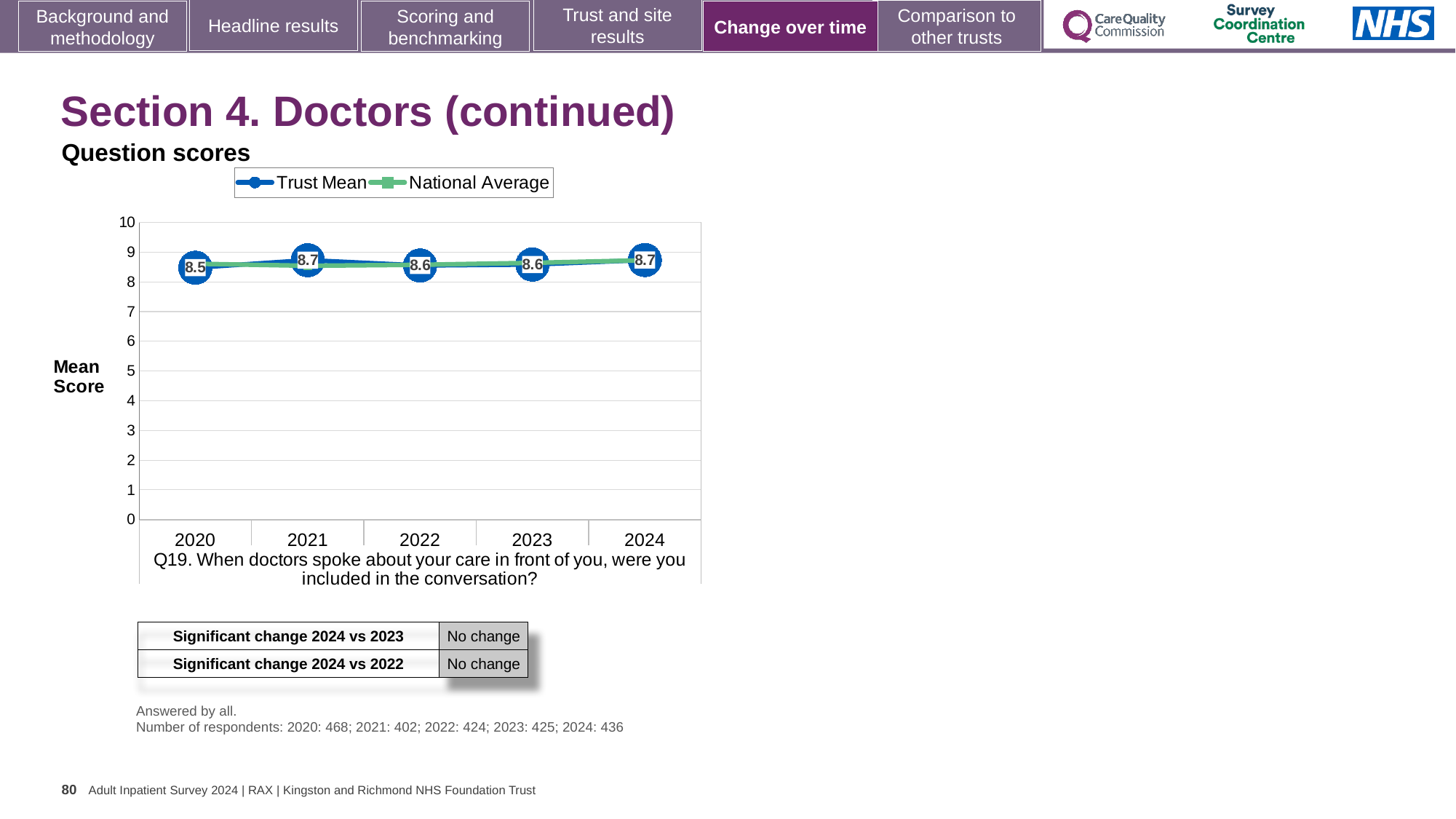
In which year is the Trust Mean score lowest? 2020 What is the Trust Mean score for 2021? 8.7 What is the Trust Mean score for 2020? 8.5 Is the National Average value for 2024 greater or less than 8? greater What kind of chart is shown on the slide? Line chart How many years are plotted on the x axis? 5 What is the difference between the Trust Mean score in 2024 and in 2020? 0.2 What is the Trust Mean score for 2022? 8.6 How many series does the legend list? 2 Which year has the larger Trust Mean score, 2020 or 2021? 2021 What are the two series named in the legend? Trust Mean and National Average What is the Trust Mean score for 2024? 8.7